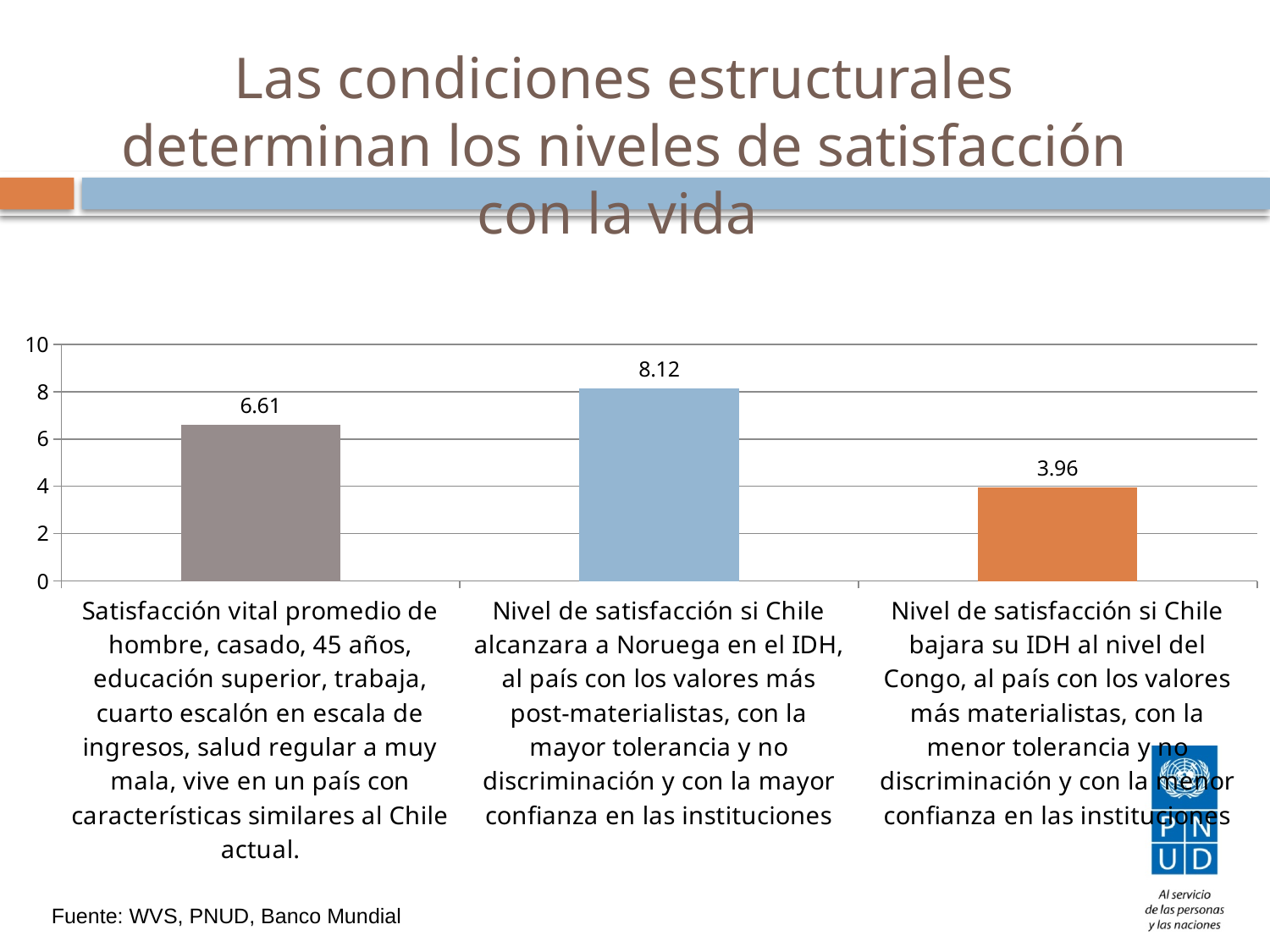
What is the maximum value shown on the vertical axis? 10 What is the difference between the Norway scenario (8.12) and the Congo scenario (3.96)? 4.16 What is the value for the scenario where Chile reaches Norway's HDI level (Nivel de satisfacción si Chile alcanzara a Noruega en el IDH)? 8.12 Which is larger: the value for the current Chile profile or the value for the Congo scenario? Satisfacción vital promedio (current Chile profile) What is the average life satisfaction value for the current Chile profile (Satisfacción vital promedio)? 6.61 What kind of chart is shown on the slide? Bar chart Which category has the highest value? Nivel de satisfacción si Chile alcanzara a Noruega en el IDH What is the value for the scenario where Chile's HDI falls to the level of Congo (Nivel de satisfacción si Chile bajara su IDH al nivel del Congo)? 3.96 Which category has the lowest value? Nivel de satisfacción si Chile bajara su IDH al nivel del Congo Is the value for the Congo scenario greater or less than 4? less How many bars are shown in the chart? 3 What is the difference between the Norway scenario value and the current Chile profile value? 1.51